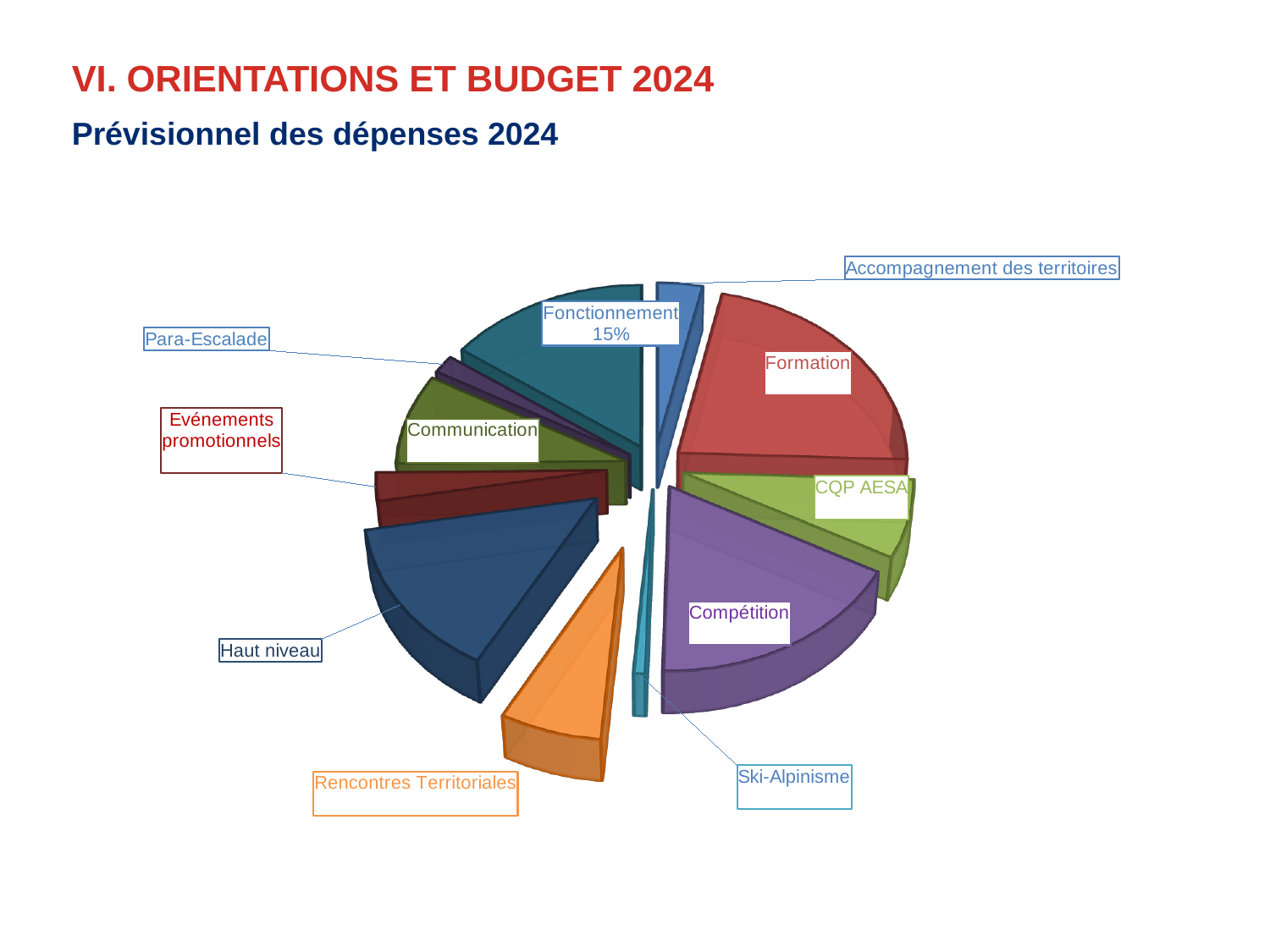
How many slices does the pie chart have? 11 Which slice is the only one with a percentage printed on the chart? Fonctionnement What colour is the slice for Rencontres Territoriales? orange Which is larger, the slice for Compétition or the slice for Para-Escalade? Compétition Which is larger, the slice for Formation or the slice for Ski-Alpinisme? Formation What is the title of the chart on the slide? Prévisionnel des dépenses 2024 What kind of chart is shown on the slide? pie chart What share of the pie does Fonctionnement represent? 15% Which is larger, the slice for Rencontres Territoriales or the slice for Ski-Alpinisme? Rencontres Territoriales